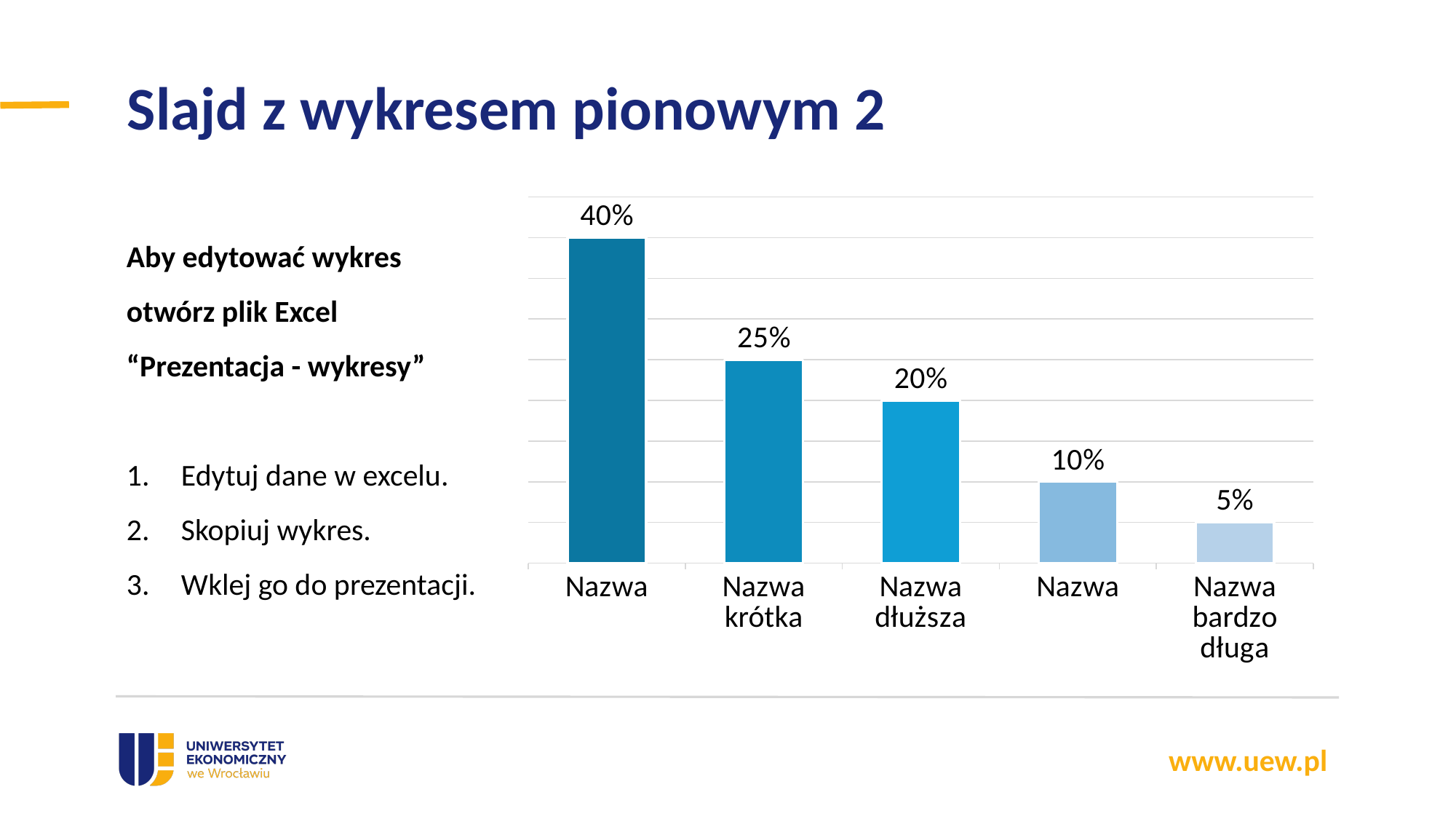
How many bars does the chart have? 5 What is the value for "Nazwa krótka"? 25% What is the value for "Nazwa dłuższa"? 20% What is the value for "Nazwa bardzo długa"? 5% What kind of chart is shown on the slide? Bar chart Which category has the highest value? Nazwa (the first bar) Which category has the lowest value? Nazwa bardzo długa What is the value of the fourth bar, labelled "Nazwa"? 10% Which is larger, the value for "Nazwa dłuższa" or "Nazwa bardzo długa"? Nazwa dłuższa What is the difference between the first bar ("Nazwa", 40%) and "Nazwa bardzo długa"? 35% What is the value of the first bar on the left, labelled "Nazwa"? 40% What is the difference between the values for "Nazwa krótka" and "Nazwa dłuższa"? 5%